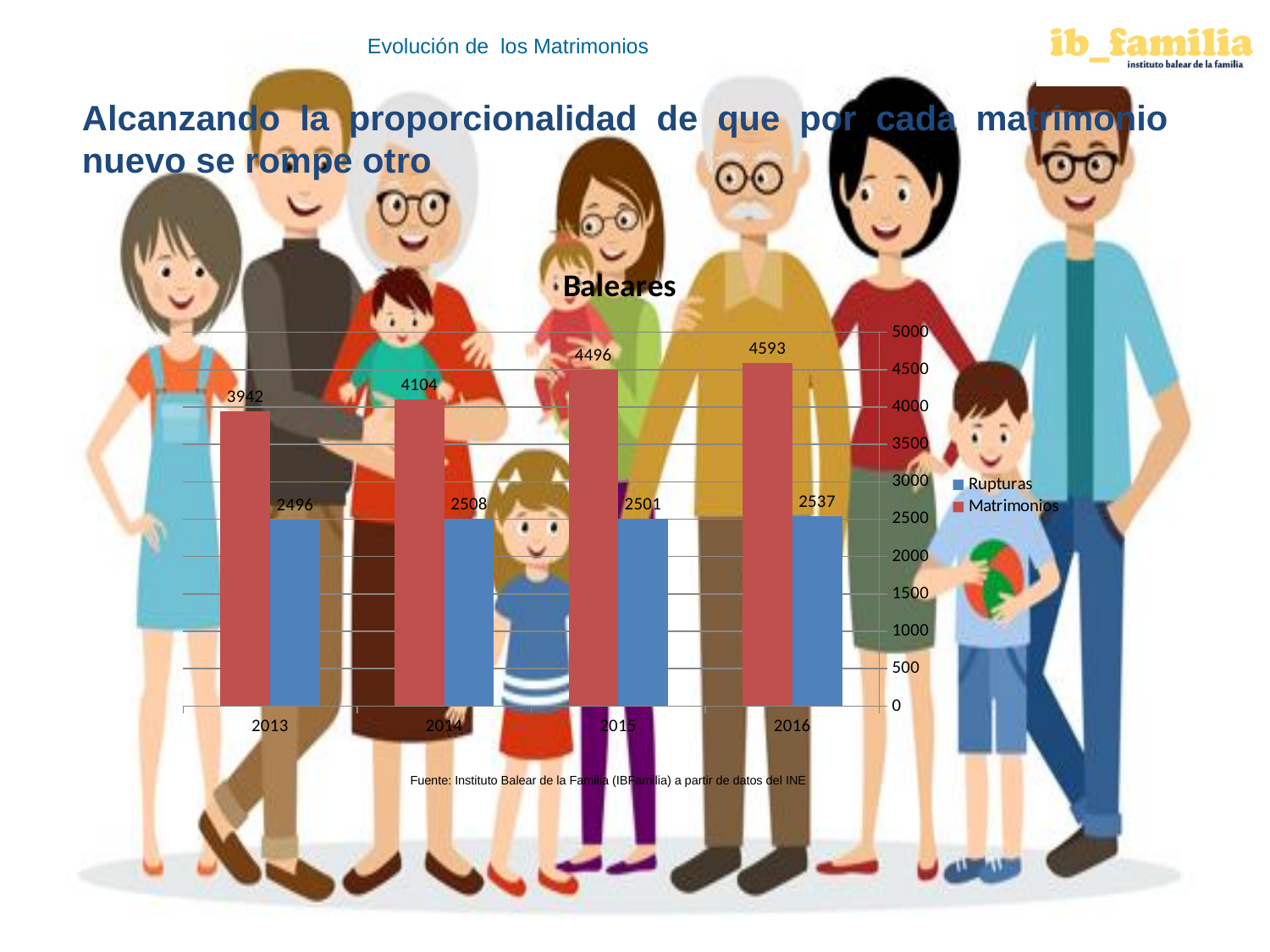
Do the Matrimonios values rise or fall from 2013 to 2016? rise In which year is the Matrimonios value lowest? 2013 In which year is the Matrimonios value highest? 2016 How many years are shown on the x axis? 4 How many series does the legend list? 2 Which is larger in 2014, Matrimonios or Rupturas? Matrimonios What is the value for Matrimonios in 2015? 4496 What is the value for Matrimonios in 2013? 3942 What is the difference between Matrimonios and Rupturas in 2016? 2056 What is the difference between the Matrimonios values for 2014 and 2013? 162 What is the value for Rupturas in 2016? 2537 What kind of chart is shown? bar chart